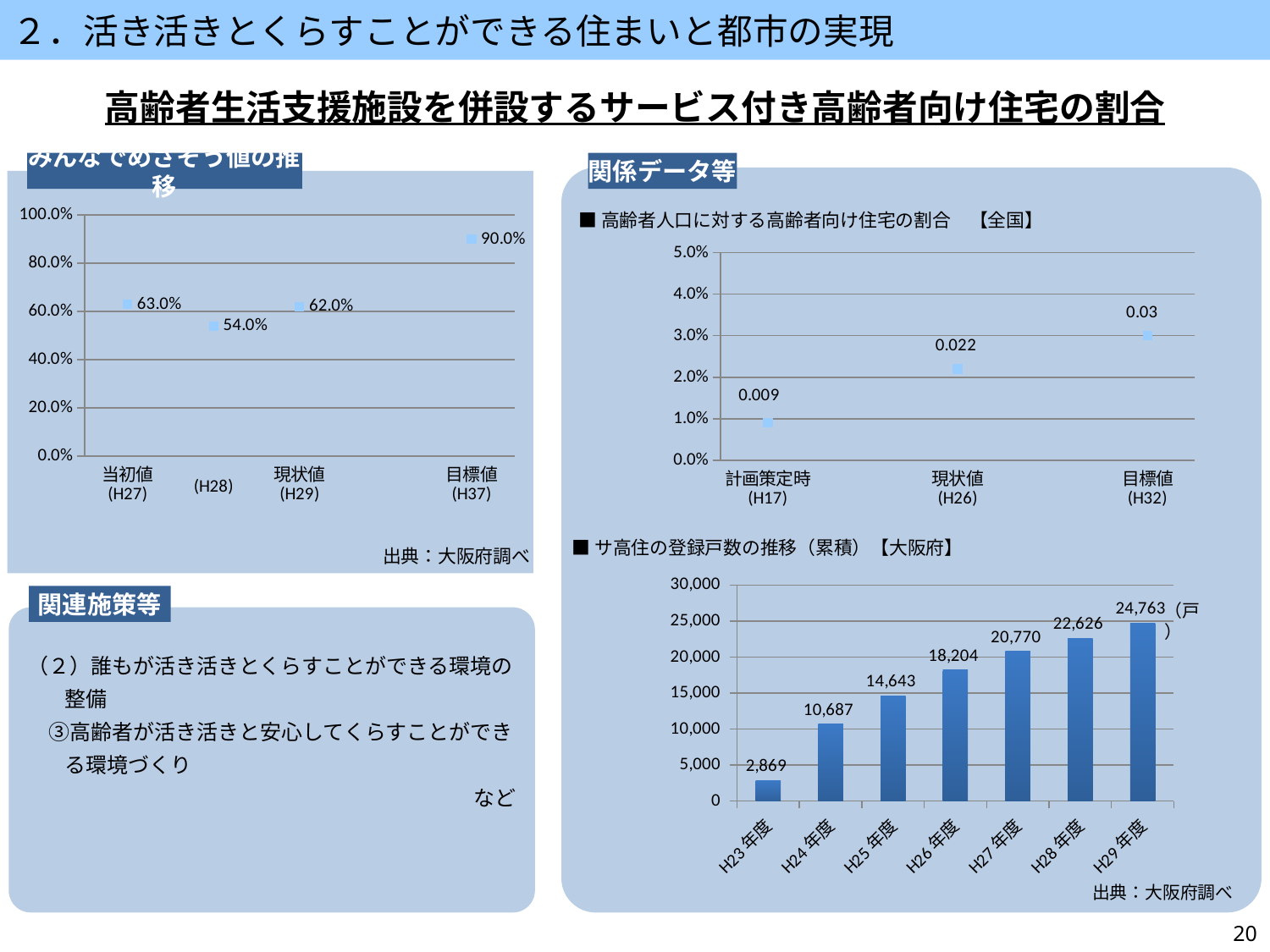
In the chart titled みんなでめざそう値の推移, what is the value for H28? 54.0% What kind of chart is the chart titled サ高住の登録戸数の推移（累積）【大阪府】? bar chart In the chart titled サ高住の登録戸数の推移（累積）【大阪府】, how many bars are there? 7 In the chart titled サ高住の登録戸数の推移（累積）【大阪府】, what is the difference between H29年度 and H28年度? 2,137 In the chart titled 高齢者人口に対する高齢者向け住宅の割合【全国】, what is the value for 現状値 (H26)? 0.022 In the chart titled みんなでめざそう値の推移, which point has the lowest value? H28 In the chart titled みんなでめざそう値の推移, what is the difference between the 当初値 (H27) and 現状値 (H29) values? 1.0% In the chart titled みんなでめざそう値の推移, what is the value for 目標値 (H37)? 90.0% In the chart titled 高齢者人口に対する高齢者向け住宅の割合【全国】, how many data points are plotted? 3 In the chart titled 高齢者人口に対する高齢者向け住宅の割合【全国】, which point has the highest value? 目標値 (H32) In the chart titled サ高住の登録戸数の推移（累積）【大阪府】, do the values rise or fall from H23年度 to H29年度? rise In the chart titled サ高住の登録戸数の推移（累積）【大阪府】, what is the value for H26年度? 18,204